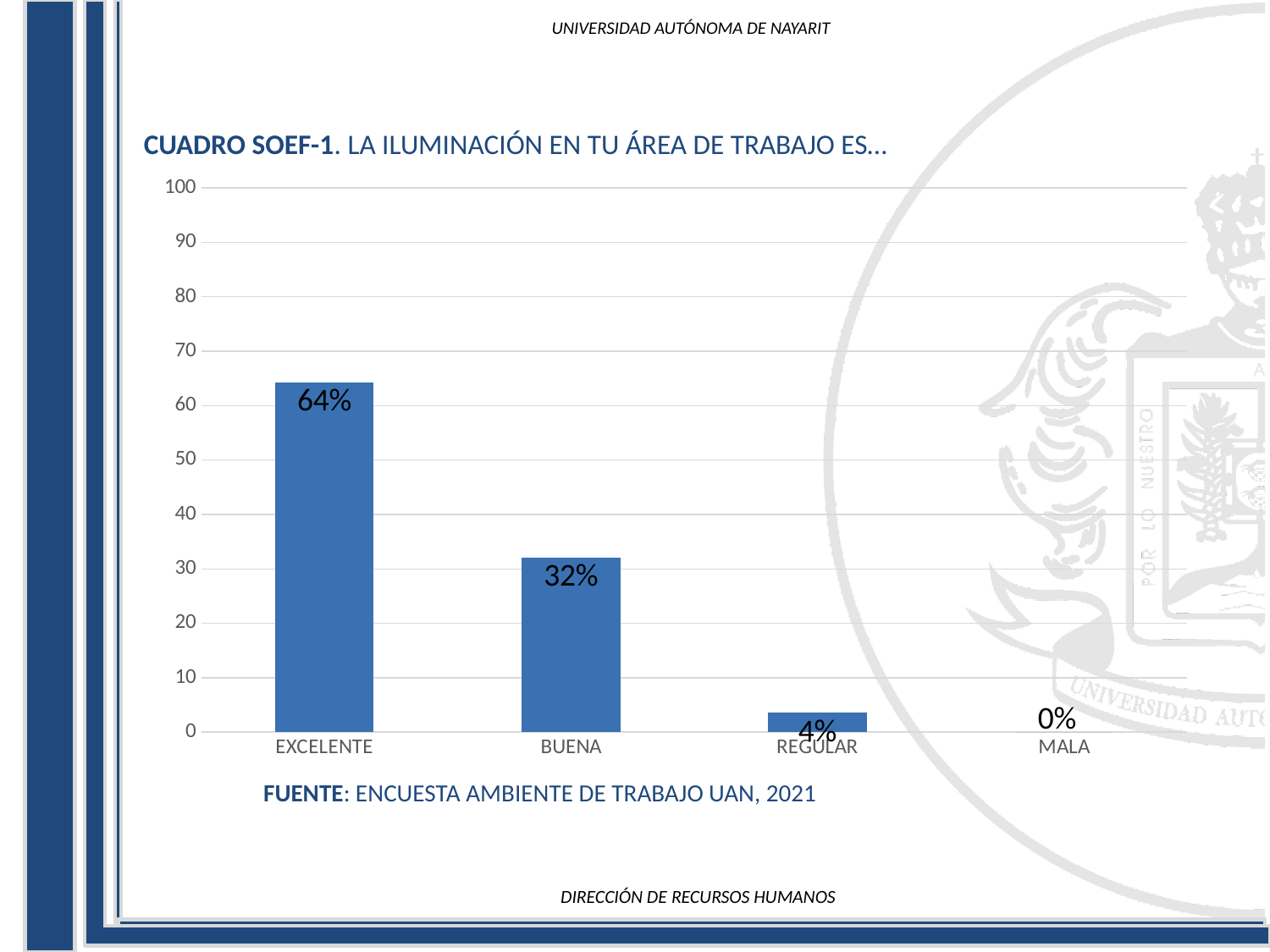
Which is larger, the value for BUENA or the value for REGULAR? BUENA Which category has the highest value? EXCELENTE What is the value for BUENA? 32% What is the value for REGULAR? 4% How many categories are shown on the x axis? 4 What kind of chart is shown on the slide? bar chart What is the value for EXCELENTE? 64% Is the value for EXCELENTE greater or less than 50? greater What is the difference between the values for EXCELENTE and BUENA? 32% Do the values rise or fall from left to right along the x axis? fall What is the value for MALA? 0% Which category has the lowest value? MALA